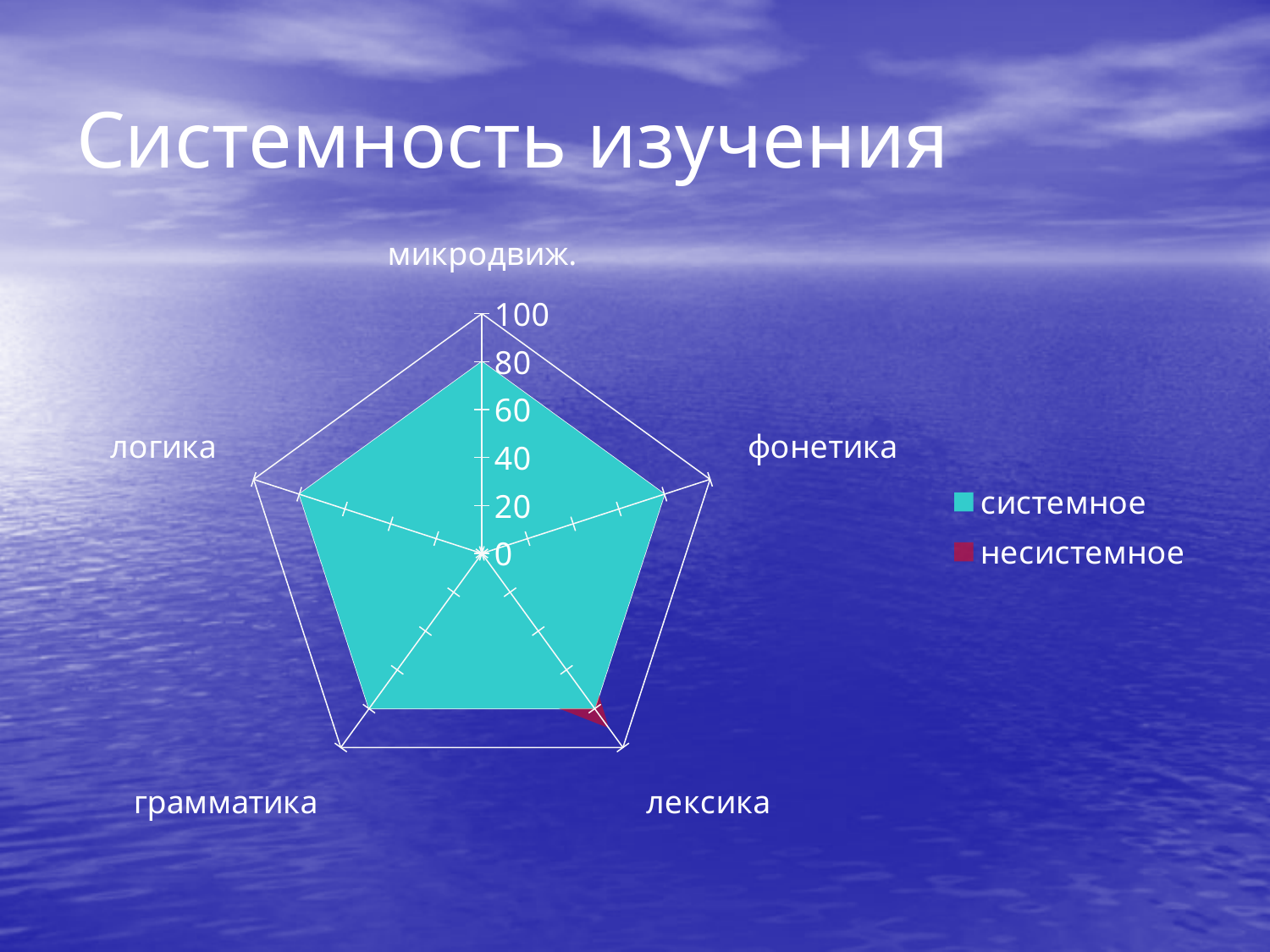
What are the two series named in the legend? системное, несистемное What is the maximum value shown on the radar chart's axis scale? 100 Which colour represents the series системное? cyan Is the value of системное for микродвиж. greater or less than 100? less How many categories (axes) does the radar chart have? 5 How many series does the legend list? 2 Is the value of системное for микродвиж. greater or less than 60? greater Is the value of системное for логика greater or less than 100? less What kind of chart is shown on the slide? radar chart